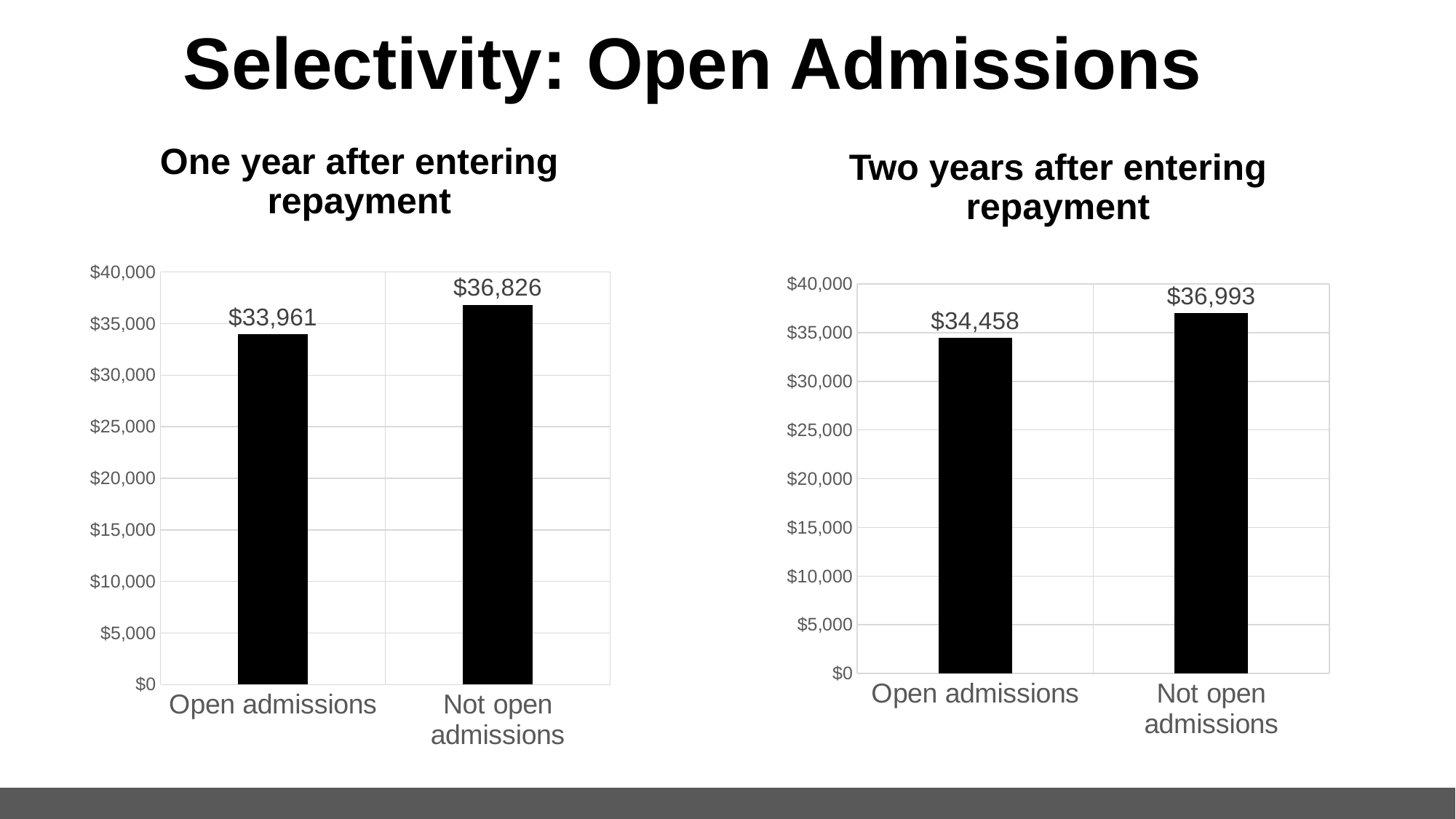
In the 'Two years after entering repayment' chart, which category has the lower value? Open admissions In the 'One year after entering repayment' chart, which category has the higher value? Not open admissions What is the title of the chart on the left side of the slide? One year after entering repayment In the 'One year after entering repayment' chart, what is the value for Not open admissions? $36,826 In the 'Two years after entering repayment' chart, what is the value for Not open admissions? $36,993 What type of chart is the 'Two years after entering repayment' chart? Bar chart In the 'One year after entering repayment' chart, what is the difference between Not open admissions and Open admissions? $2,865 In the 'Two years after entering repayment' chart, what is the value for Open admissions? $34,458 In the 'One year after entering repayment' chart, what is the value for Open admissions? $33,961 In the 'Two years after entering repayment' chart, is the value for Open admissions greater or less than $35,000? less In the 'Two years after entering repayment' chart, what is the difference between Not open admissions and Open admissions? $2,535 In the 'One year after entering repayment' chart, how many categories are shown? 2